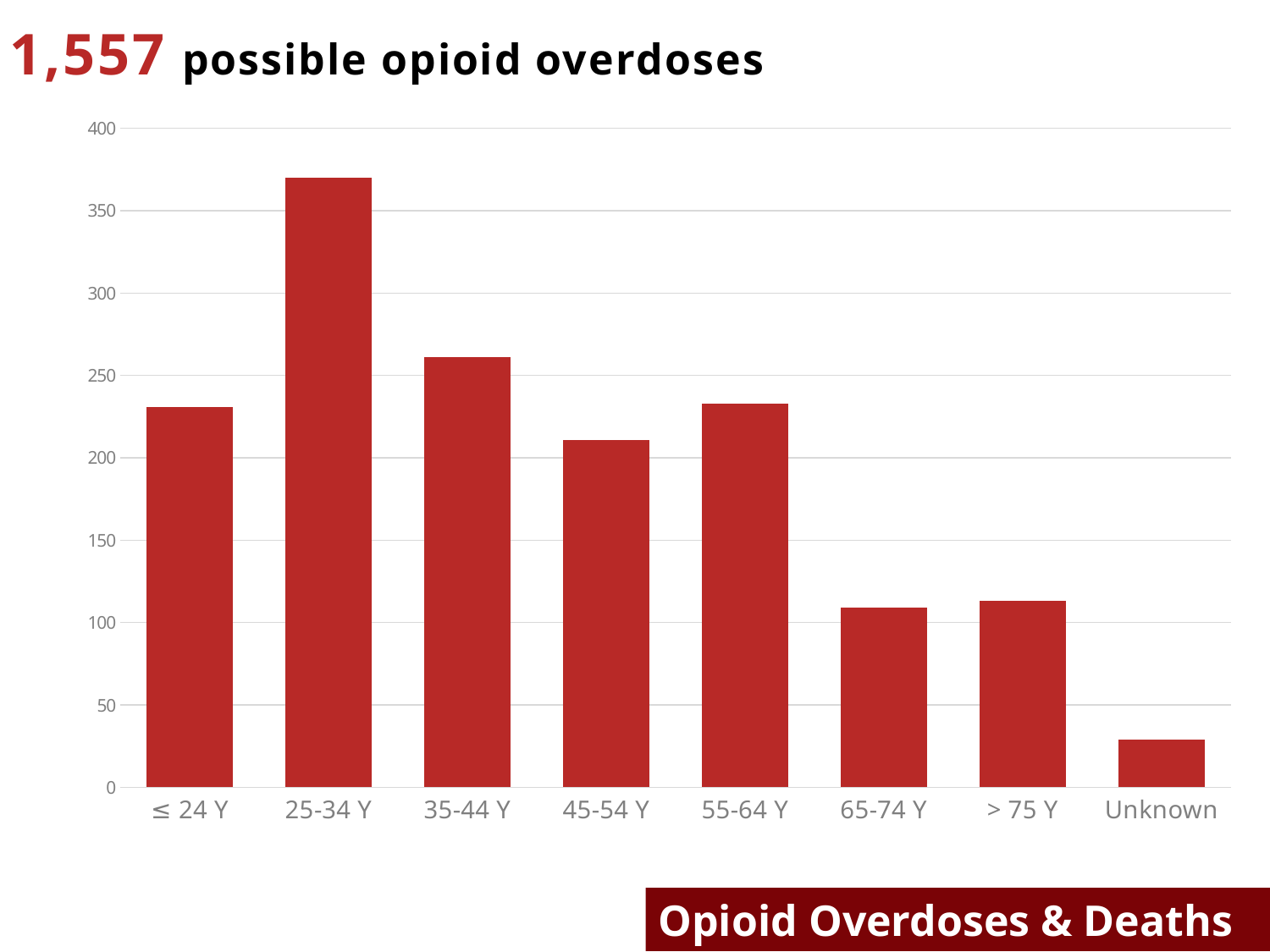
What total number of possible opioid overdoses is stated in the slide title? 1,557 Is the value for Unknown greater or less than 50? less Which category has the lowest number of possible opioid overdoses? Unknown Which is larger, the value for 55-64 Y or the value for 65-74 Y? 55-64 Y Which age category has the highest number of possible opioid overdoses? 25-34 Y Is the value for 25-34 Y greater or less than 350? greater How many age categories are shown on the x axis? 8 Is the value for 35-44 Y greater or less than 250? greater What kind of chart is shown on the slide? bar chart Which is larger, the value for 35-44 Y or the value for 45-54 Y? 35-44 Y